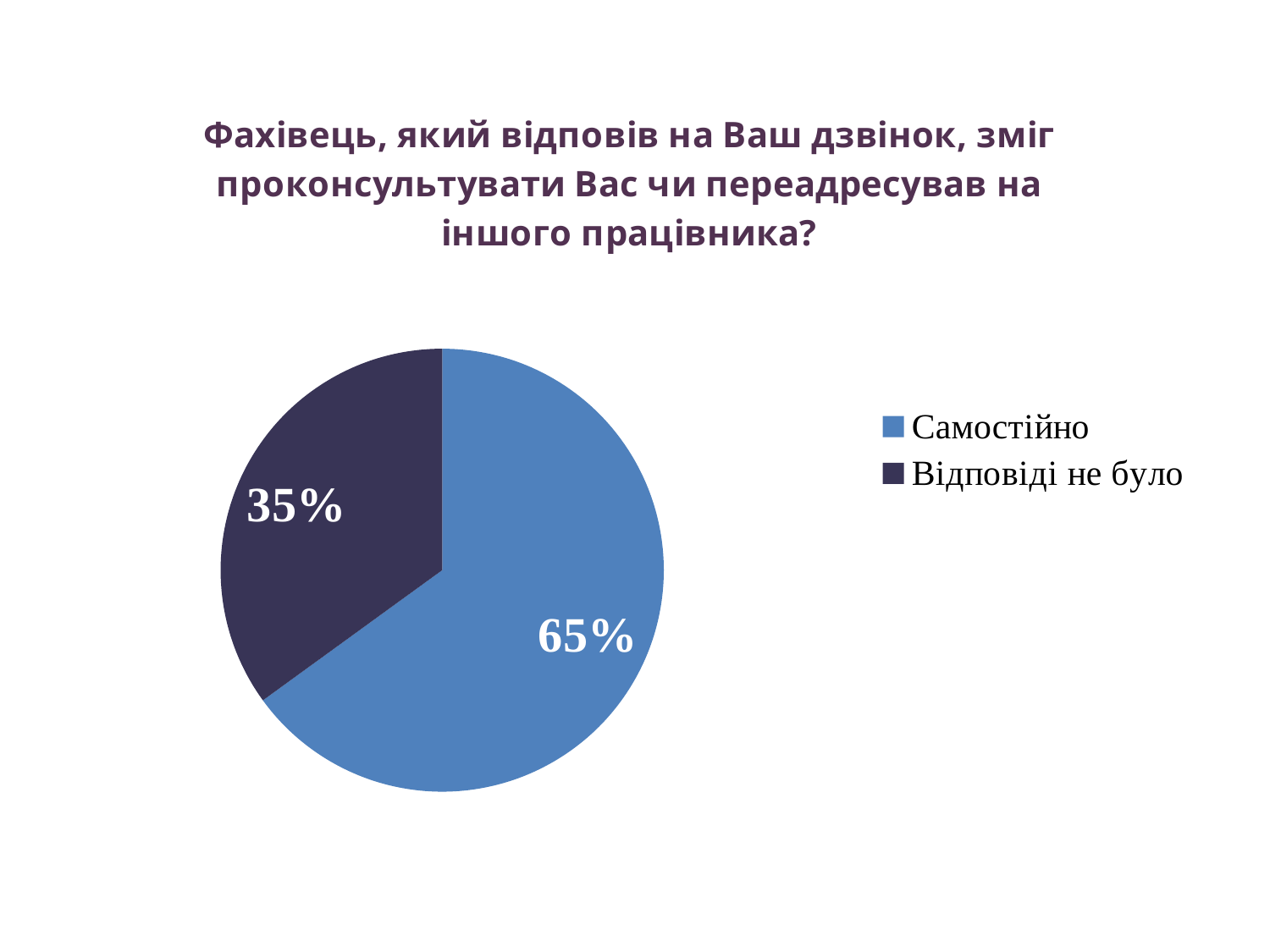
What colour is the "Самостійно" slice? Blue Which is larger: the "Самостійно" slice or the "Відповіді не було" slice? Самостійно What is the difference in percentage points between the "Самостійно" and "Відповіді не було" slices? 30 Which legend entry is shown in dark navy? Відповіді не було How many entries does the legend list? 2 How many slices does the pie chart have? 2 Which category has the largest share of the pie? Самостійно What percentage does the "Самостійно" slice show? 65% Which category has the smallest share of the pie? Відповіді не було What kind of chart is shown on the slide? Pie chart What percentage does the "Відповіді не було" slice show? 35% What share of the pie does the "Відповіді не було" slice represent? 35%